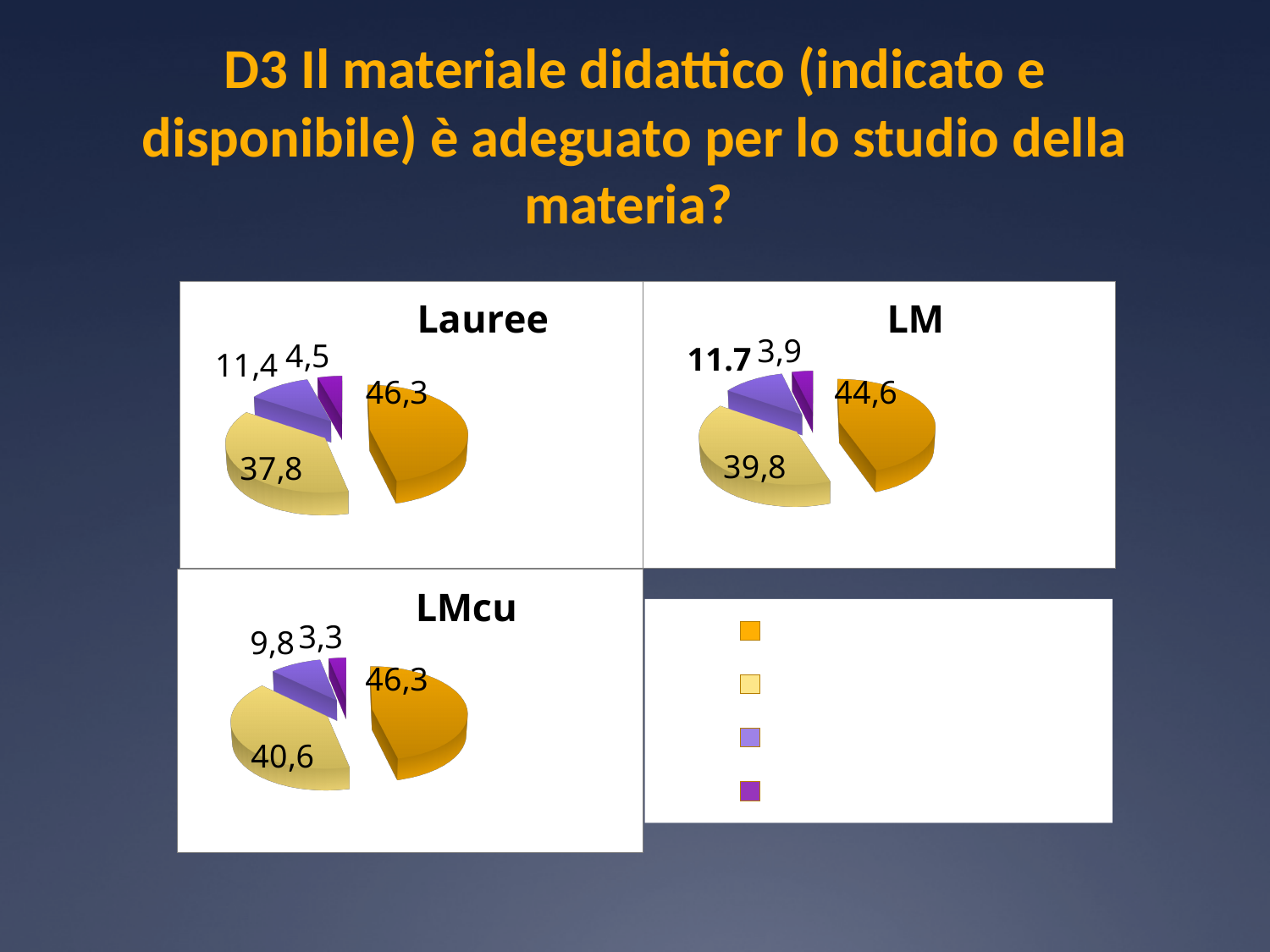
How many colour swatches does the legend box at the bottom right show? 4 In the Lauree chart, which slice has the largest value? the orange slice (46,3) In the LMcu chart, what value is shown for the light purple slice? 9,8 How many pie charts are shown on the slide? 3 Is the orange slice larger in the Lauree chart or in the LM chart? Lauree (46,3 vs 44,6) In the LM chart, what value is shown for the dark purple slice? 3,9 In the LMcu chart, which slice has the smallest value? the dark purple slice (3,3) In the LM chart, what value is shown for the light yellow slice? 39,8 In the Lauree chart, what value is shown for the orange slice? 46,3 How many slices does the LM pie chart have? 4 In the Lauree chart, what is the difference between the orange slice (46,3) and the light yellow slice (37,8)? 8,5 What kind of chart is used for Lauree, LM and LMcu? pie chart